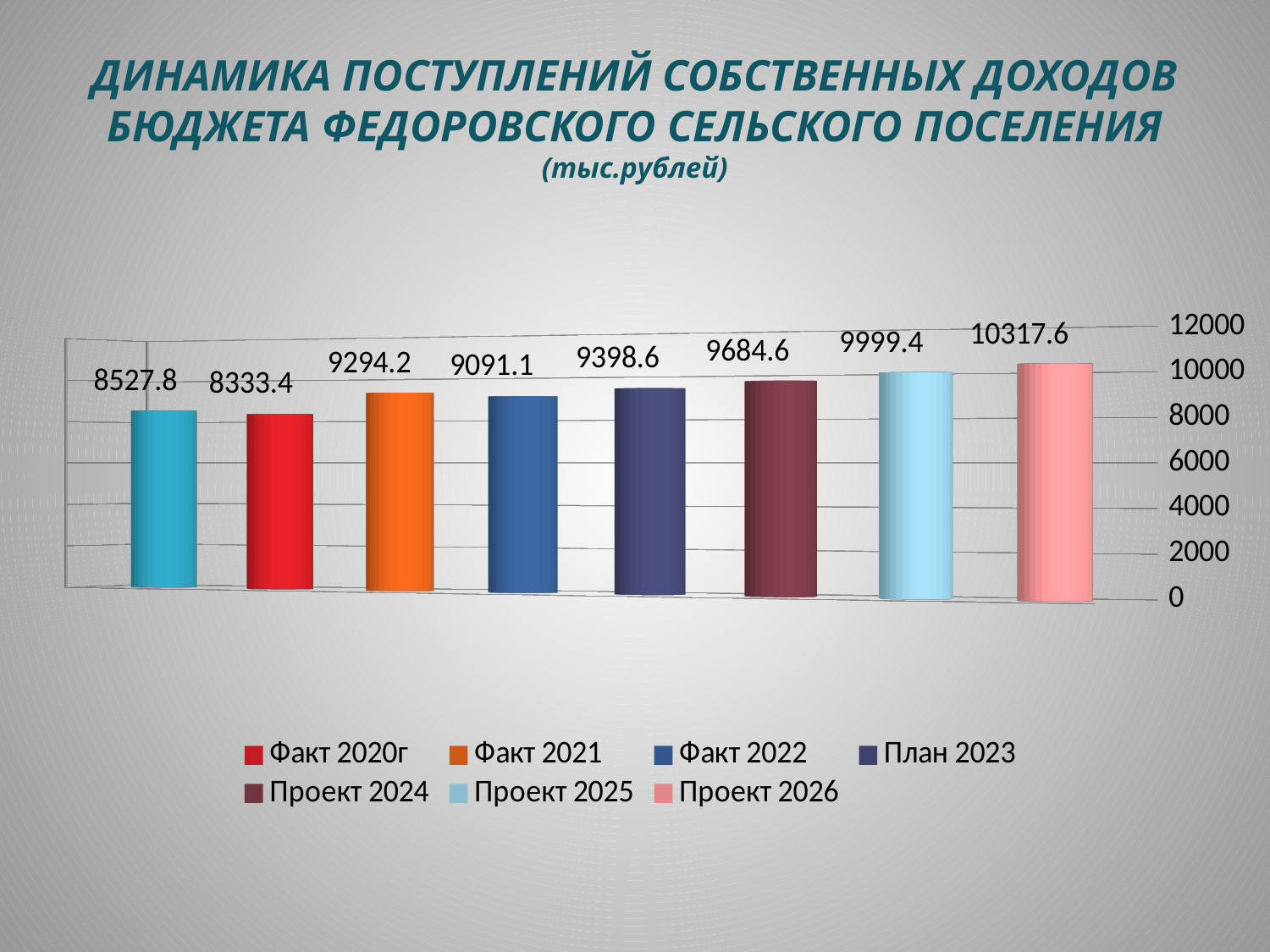
What is the value for Факт 2022? 9091.1 How many entries does the legend list? 7 What is the value for Проект 2026? 10317.6 What is the difference between Факт 2021 and Факт 2022? 203.1 Which legend entry has the highest value? Проект 2026 What is the value for Факт 2020г? 8333.4 Which legend entry has the lowest value? Факт 2020г What is the difference between Проект 2026 and Проект 2025? 318.2 What kind of chart is shown on the slide? Bar chart How many bars are plotted on the chart? 8 What is the value for План 2023? 9398.6 Which is larger, Факт 2021 or Факт 2022? Факт 2021